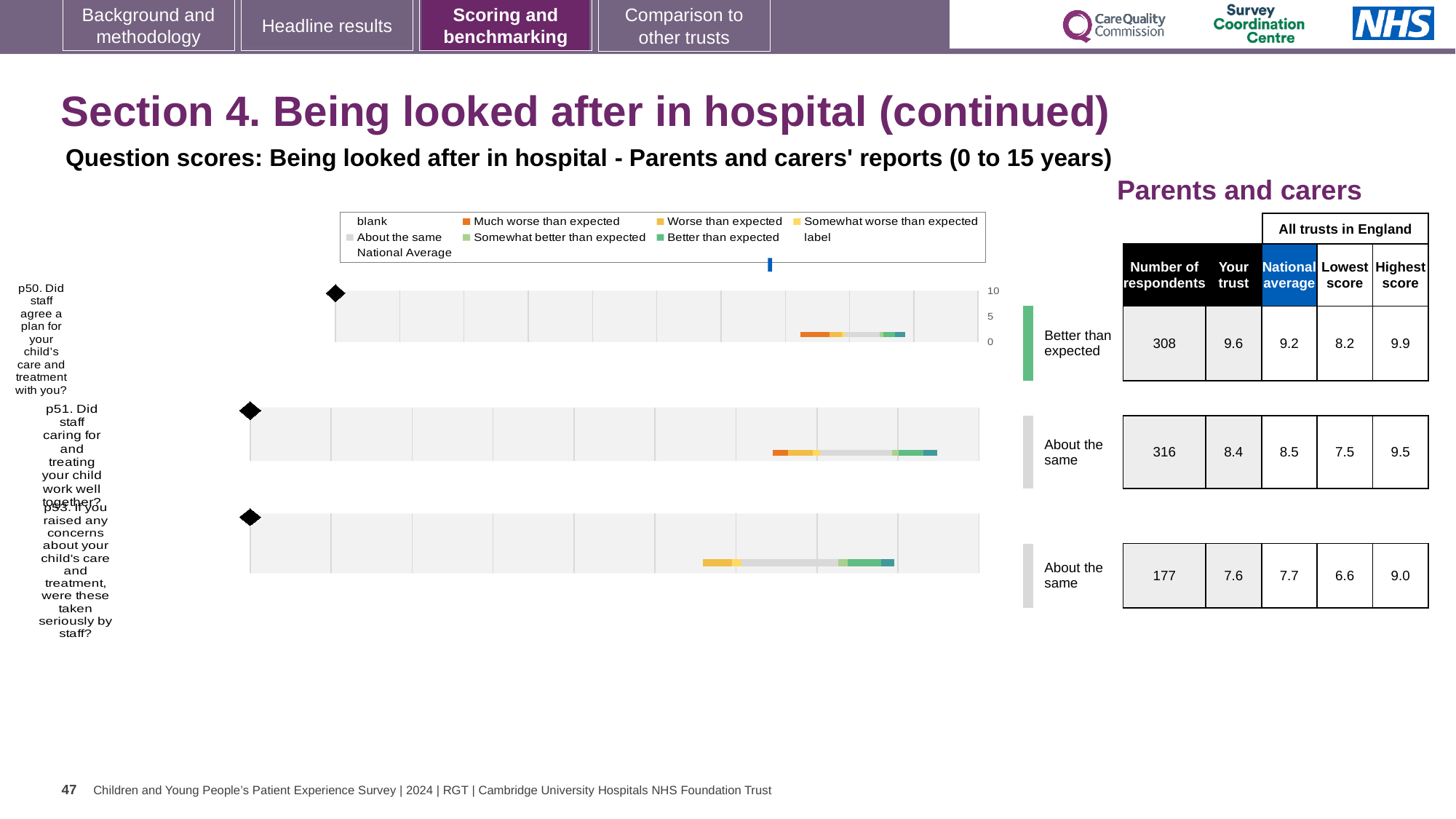
What is the difference between the national average and the 'Your trust' score for p51? 0.1 What benchmark category is shown for p50? Better than expected What is the national average score for p51 (Did staff caring for and treating your child work well together?)? 8.5 Which of the three questions shown has the lowest number of respondents? p53 For p50, which is larger: the 'Your trust' score or the national average? Your trust How many survey questions are plotted on this slide? 3 What kind of chart is used to show the question scores on this slide? Bar chart What is the 'Your trust' score for p50 (Did staff agree a plan for your child's care and treatment with you?)? 9.6 Which of the three questions shown has the highest 'Your trust' score? p50 What is the highest score across all trusts in England for p50? 9.9 How many respondents are shown for p53 (If you raised any concerns about your child's care and treatment, were these taken seriously by staff?)? 177 What is the lowest score across all trusts in England for p53? 6.6